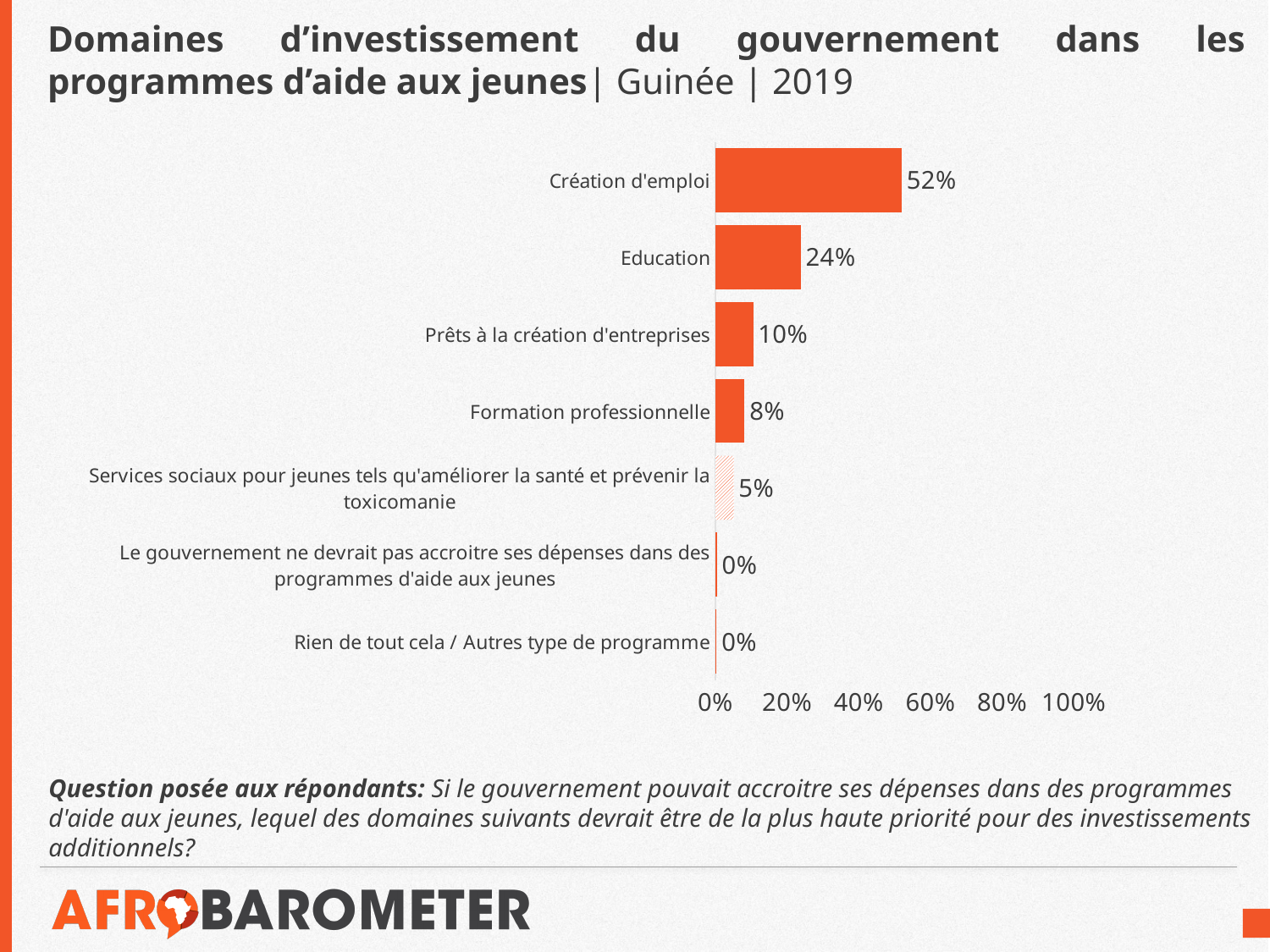
What is the difference between the values for Création d'emploi and Education? 28% What is the value for Services sociaux pour jeunes tels qu'améliorer la santé et prévenir la toxicomanie? 5% Is the value for Création d'emploi greater or less than 40%? greater Which is larger, the value for Prêts à la création d'entreprises or the value for Formation professionnelle? Prêts à la création d'entreprises How many categories are shown in the chart? 7 What is the value for Formation professionnelle? 8% What kind of chart is shown on the slide? bar chart What is the value for Création d'emploi? 52% What is the value for Prêts à la création d'entreprises? 10% What is the value for Education? 24% What is the value for Rien de tout cela / Autres type de programme? 0% Which category has the highest value? Création d'emploi